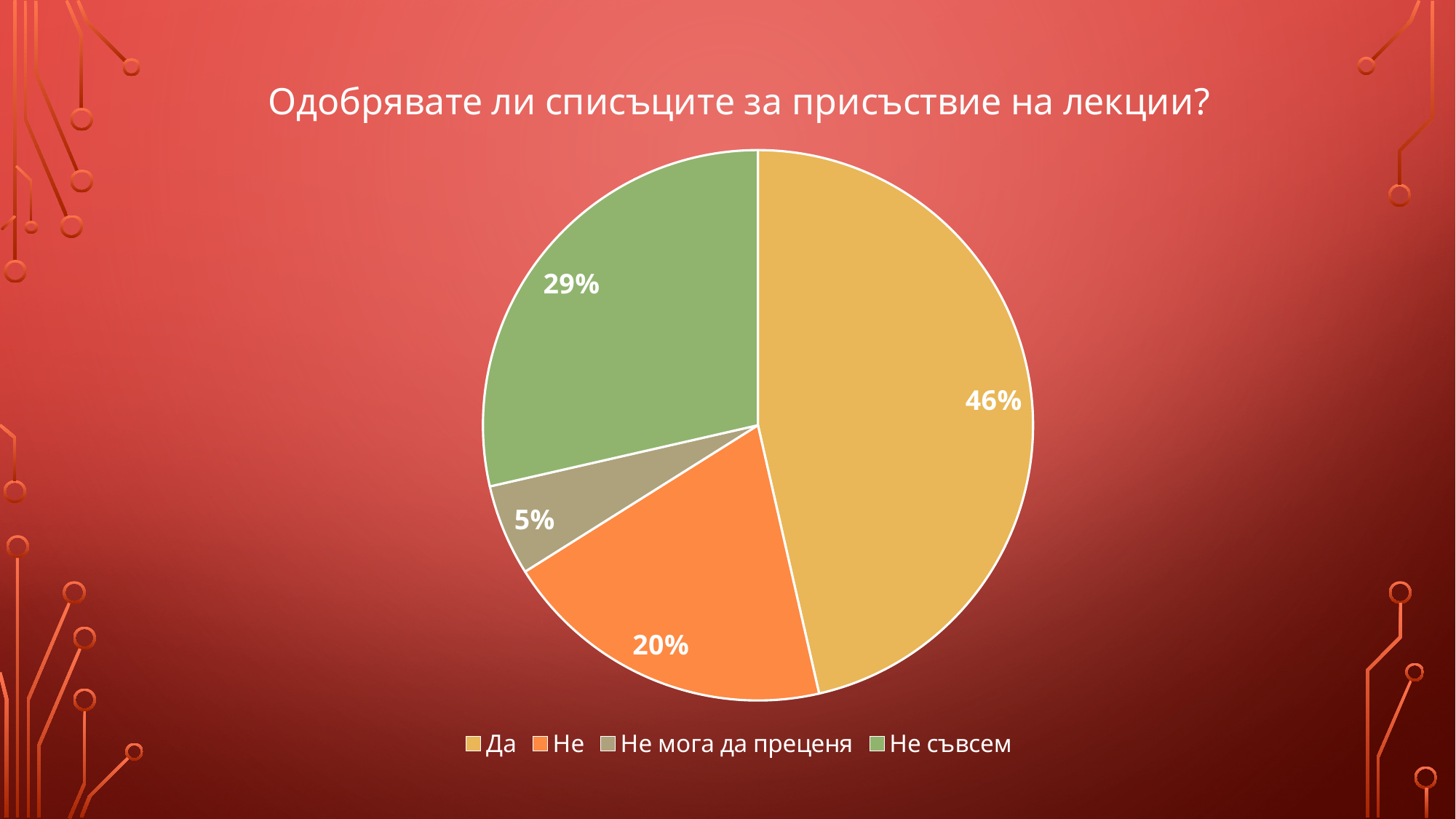
What share of the pie does "Не съвсем" represent? 29% What share of the pie does "Не мога да преценя" represent? 5% What kind of chart is shown on the slide? Pie chart Which category has the smallest slice of the pie? Не мога да преценя What is the difference in percentage points between the "Да" slice and the "Не съвсем" slice? 17% How many categories are shown in the pie chart? 4 What is the title of the chart? Одобрявате ли списъците за присъствие на лекции? What share of the pie does "Не" represent? 20% Which category has the largest slice of the pie? Да Which slice is larger, "Не" or "Не съвсем"? Не съвсем What colour is the "Не съвсем" slice? Green